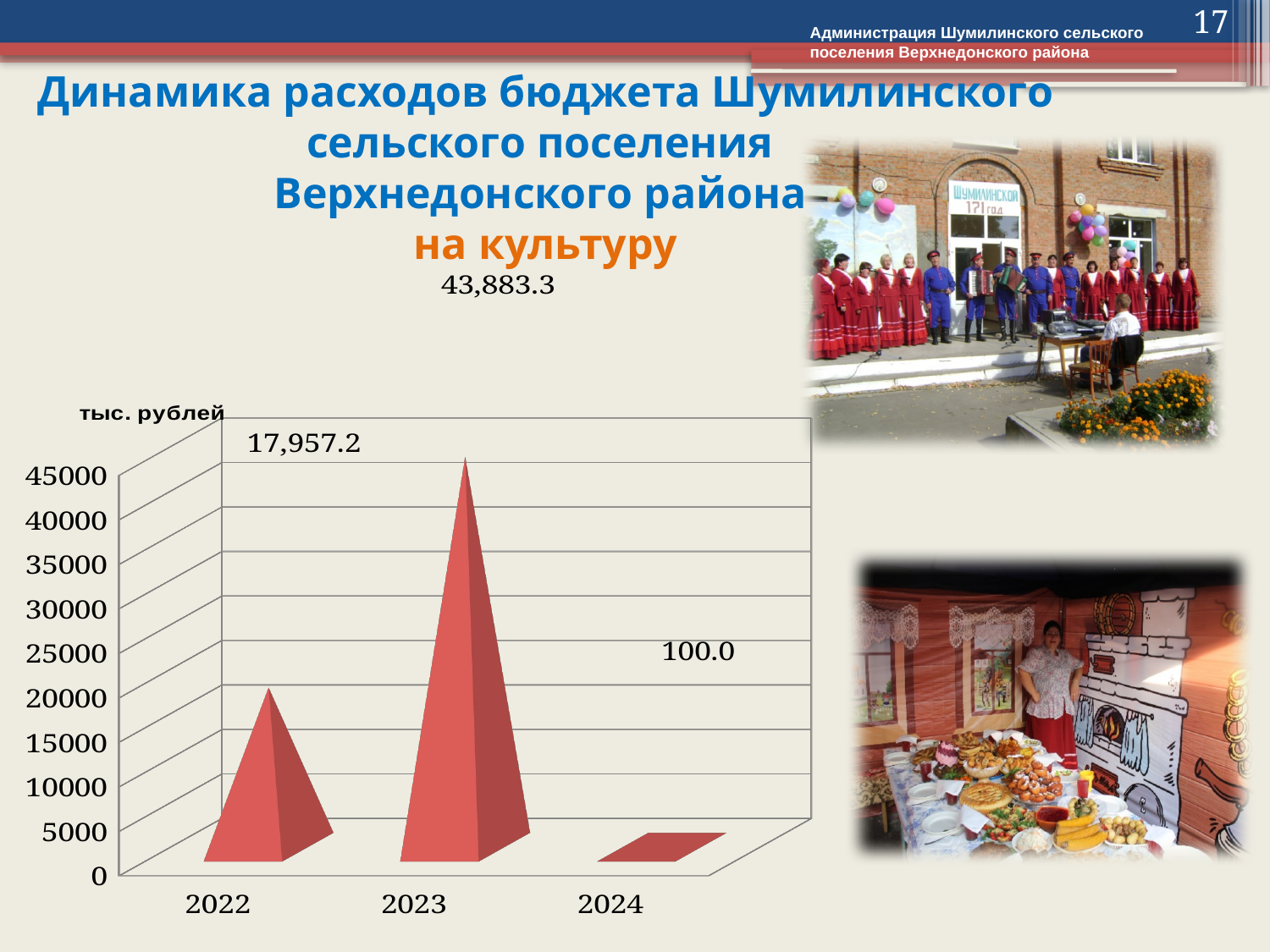
Does the value rise or fall from 2023 to 2024? fall Is the value for 2022 greater or less than 20000? less How many years are shown on the x axis of the chart? 3 What is the value for 2023 on the chart? 43,883.3 Which year has the lowest value on the chart? 2024 What is the difference between the values for 2023 and 2022? 25,926.1 What is the value for 2024 on the chart? 100.0 Which year has the highest value on the chart? 2023 Which is larger, the value for 2022 or the value for 2024? 2022 What unit is shown on the vertical axis of the chart? тыс. рублей What is the value for 2022 on the chart? 17,957.2 Is the value for 2023 greater or less than 40000? greater